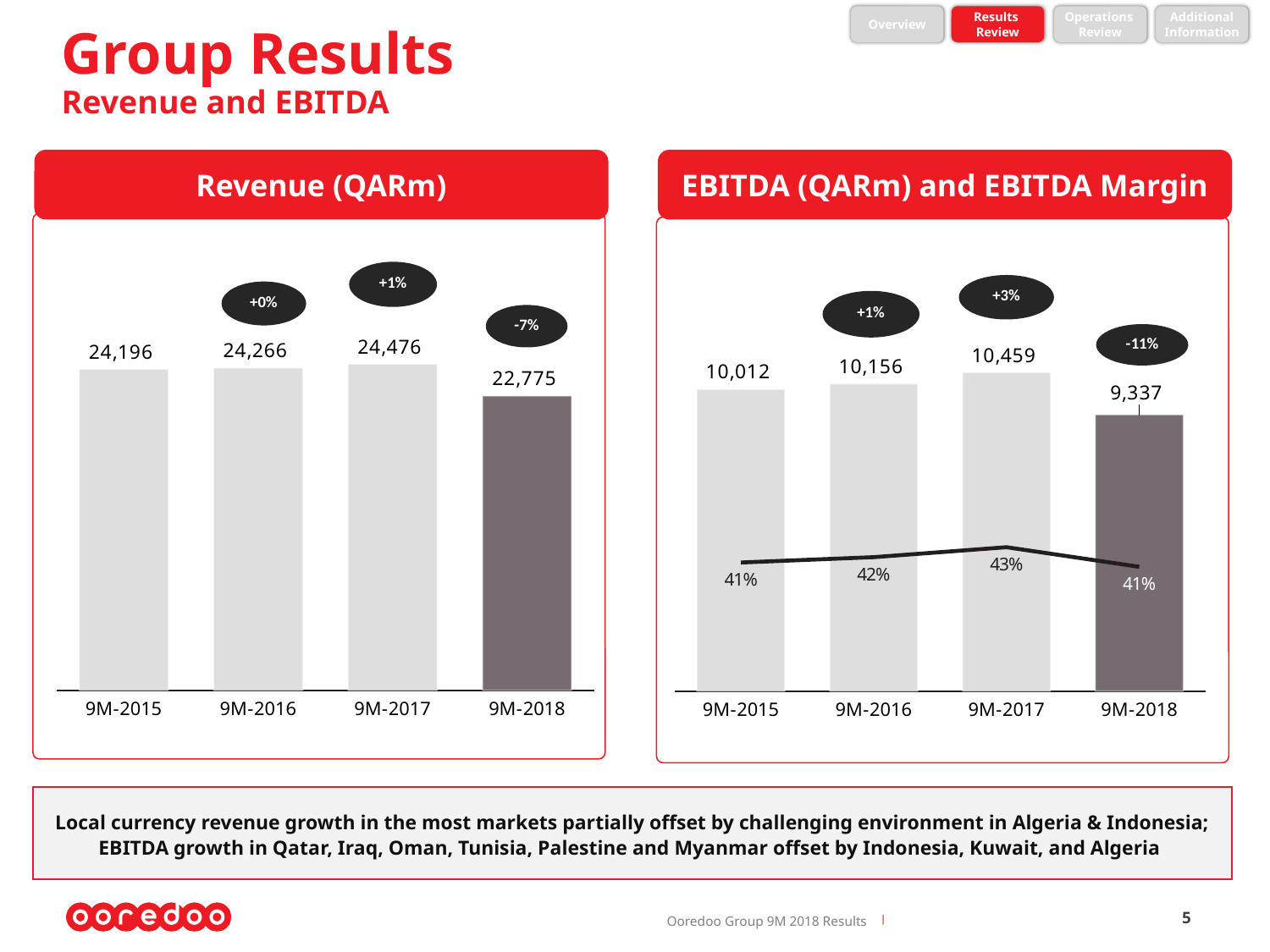
In the EBITDA (QARm) and EBITDA Margin chart, what is the EBITDA for 9M-2016? 10,156 In the EBITDA (QARm) and EBITDA Margin chart, what growth percentage is shown above the 9M-2018 bar? -11% In the Revenue (QARm) chart, what is the revenue for 9M-2017? 24,476 In the Revenue (QARm) chart, what growth percentage is shown above the 9M-2018 bar? -7% In the Revenue (QARm) chart, what is the difference between the 9M-2017 and 9M-2018 revenue values? 1,701 In the EBITDA (QARm) and EBITDA Margin chart, what is the difference between the 9M-2017 and 9M-2018 EBITDA values? 1,122 What type of chart is the Revenue (QARm) chart? bar chart In the Revenue (QARm) chart, which period has the lowest revenue? 9M-2018 In the EBITDA (QARm) and EBITDA Margin chart, what is the EBITDA margin for 9M-2017? 43% In the Revenue (QARm) chart, how many periods are shown on the x axis? 4 In the EBITDA (QARm) and EBITDA Margin chart, which period has the highest EBITDA? 9M-2017 In the EBITDA (QARm) and EBITDA Margin chart, is the EBITDA for 9M-2015 larger or smaller than the EBITDA for 9M-2018? larger